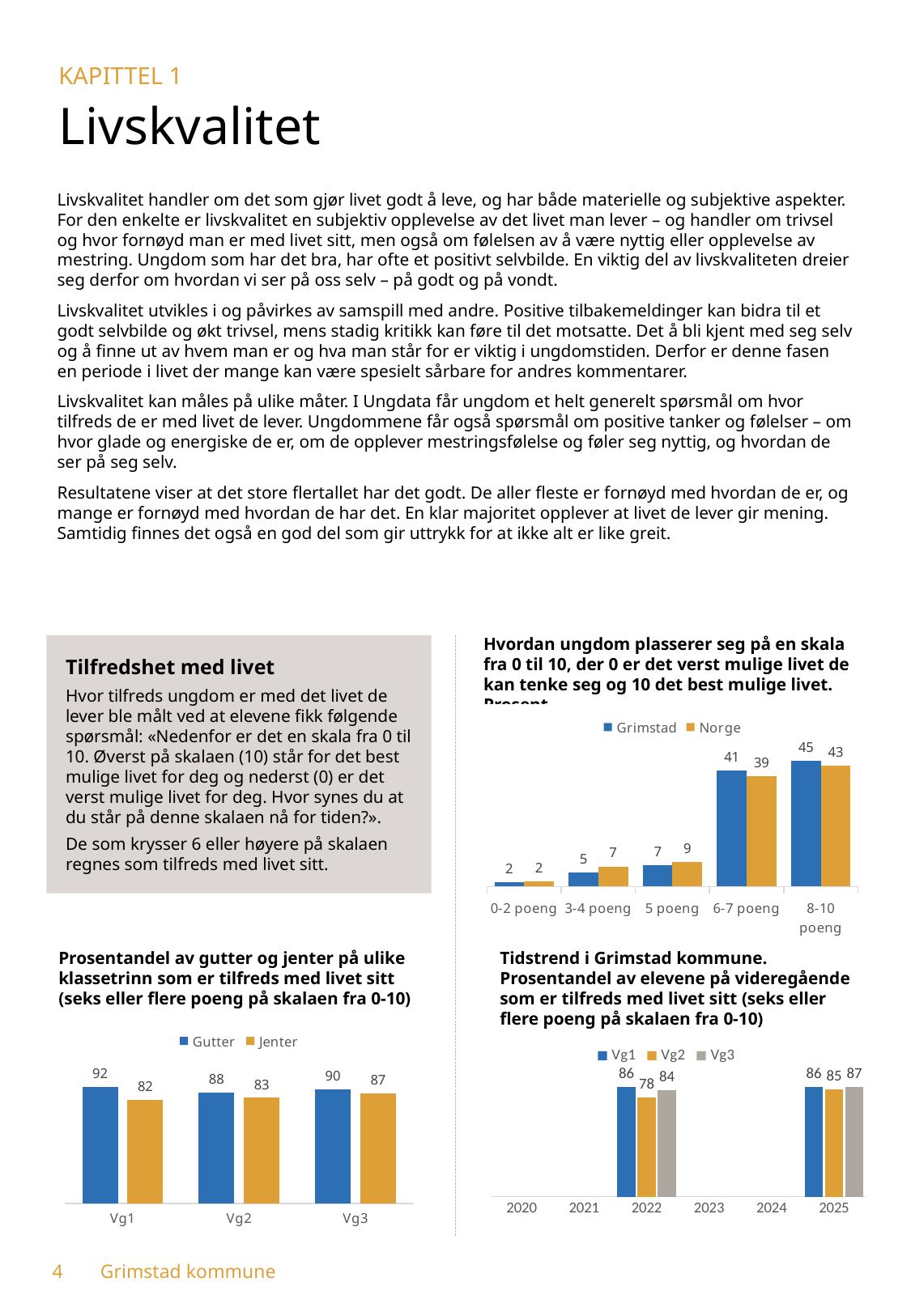
In the bottom-right chart on the time trend in Grimstad kommune, how many series does the legend list? 3 In the bottom-left chart on the share of boys and girls satisfied with life, what kind of chart is it? Bar chart In the bottom-right chart on the time trend in Grimstad kommune, what is the value for Vg2 in 2022? 78 In the top-right chart on how youth place themselves on a scale from 0 to 10, what is the difference between Norge and Grimstad in the 5 poeng category? 2 In the bottom-right chart on the time trend in Grimstad kommune, which is larger in 2025: Vg2 or Vg3? Vg3 In the top-right chart on how youth place themselves on a scale from 0 to 10, which category has the highest value for Grimstad? 8-10 poeng In the bottom-left chart on the share of boys and girls satisfied with life, what is the value for Jenter at Vg1? 82 In the bottom-left chart on the share of boys and girls satisfied with life, which class level has the lowest value for Gutter? Vg2 In the top-right chart on how youth place themselves on a scale from 0 to 10, what is the value for Norge in the 6-7 poeng category? 39 In the top-right chart on how youth place themselves on a scale from 0 to 10, how many categories are shown on the x axis? 5 In the bottom-left chart on the share of boys and girls satisfied with life, what is the difference between Gutter and Jenter at Vg1? 10 In the top-right chart on how youth place themselves on a scale from 0 to 10, what is the value for Grimstad in the 8-10 poeng category? 45